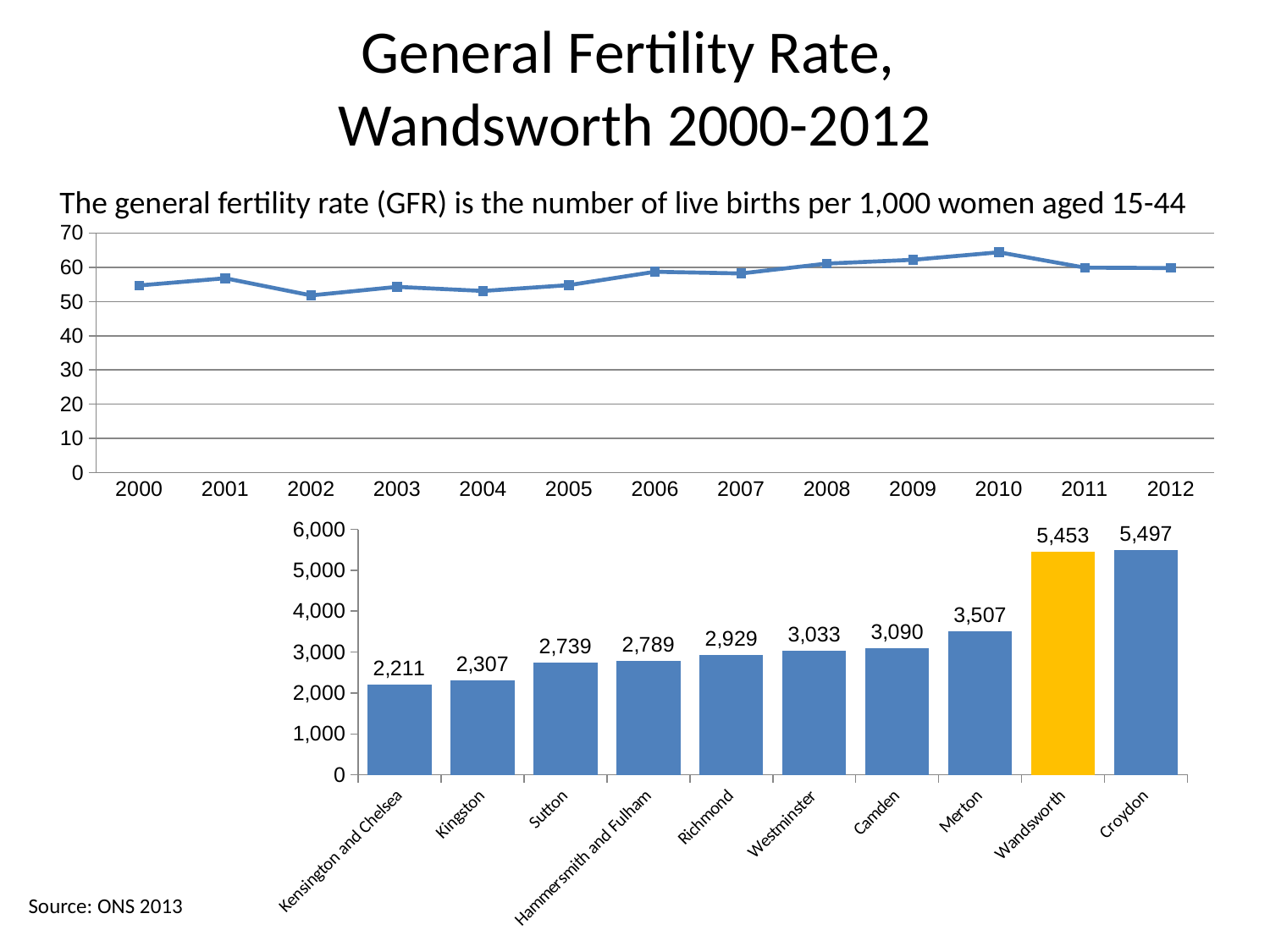
How many years are plotted in the top line chart? 13 In the bottom bar chart, what is the difference between the values for Croydon and Wandsworth? 44 In the bottom bar chart, what is the value for Merton? 3,507 In the bottom bar chart, what is the value for Wandsworth? 5,453 In the bottom bar chart, which bar is coloured differently from the others? Wandsworth In the bottom bar chart, which borough has the highest value? Croydon In the top line chart, which year has the highest general fertility rate? 2010 What type of chart is the top chart on the slide? line chart In the top line chart, which year has the lowest general fertility rate? 2002 In the top line chart, is the value for 2002 greater or less than 60? less What type of chart is the bottom chart on the slide? bar chart In the top line chart, is the value for 2010 greater or less than 60? greater